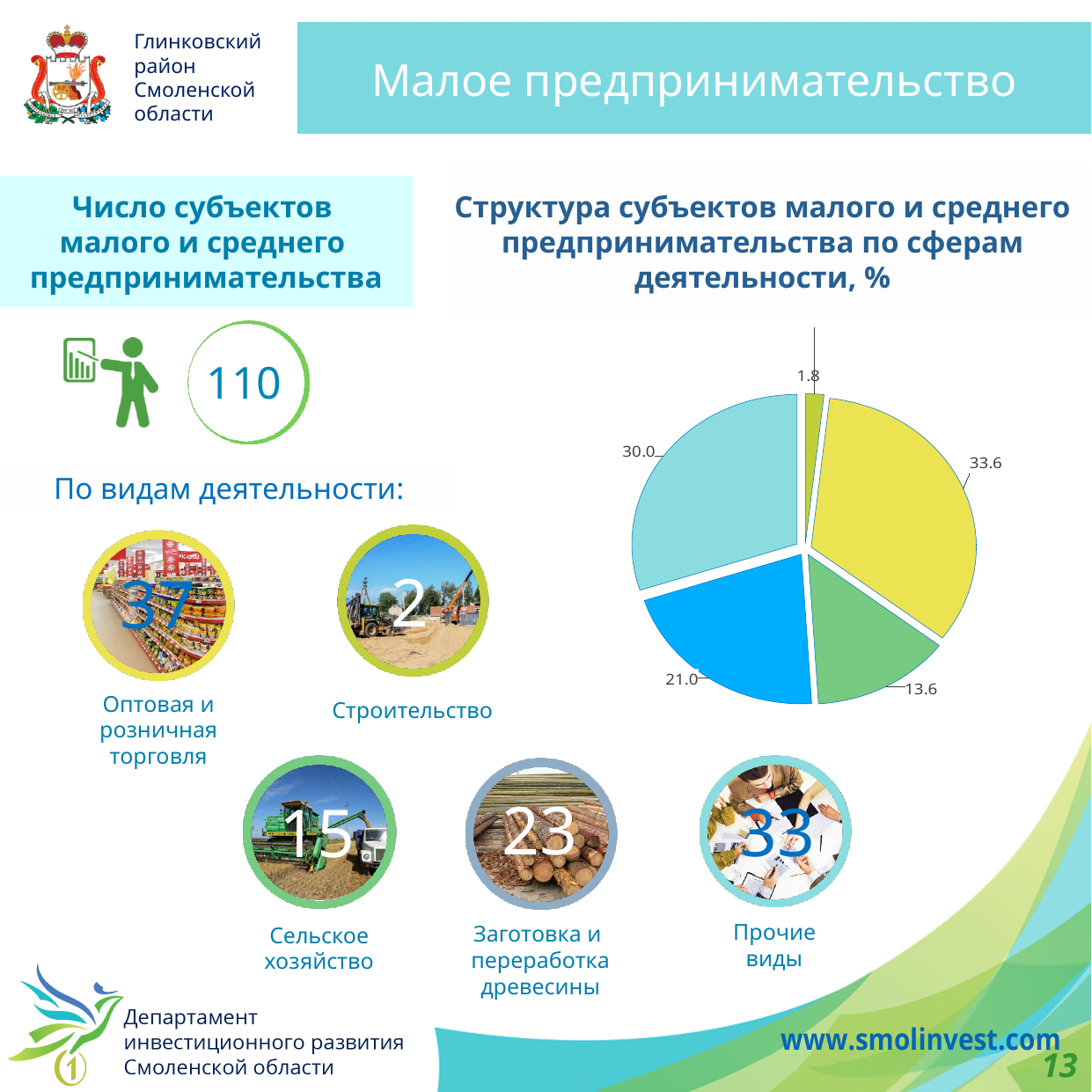
What value is labelled on the green slice of the pie chart? 13.6 Is the value of the slice labelled 13.6 on the pie chart greater or less than 20? less What is the difference between the largest and smallest slice values on the pie chart? 31.8 What value is labelled on the yellow slice of the pie chart? 33.6 On the pie chart, which is larger: the slice labelled 30.0 or the slice labelled 21.0? 30.0 What kind of chart is shown on the right side of the slide? pie chart What is the title of the pie chart? Структура субъектов малого и среднего предпринимательства по сферам деятельности, % What is the sum of all slice values labelled on the pie chart? 100.0 What is the difference between the slices labelled 30.0 and 21.0 on the pie chart? 9.0 What is the largest value labelled on the pie chart? 33.6 What is the smallest value labelled on the pie chart? 1.8 How many slices does the pie chart have? 5